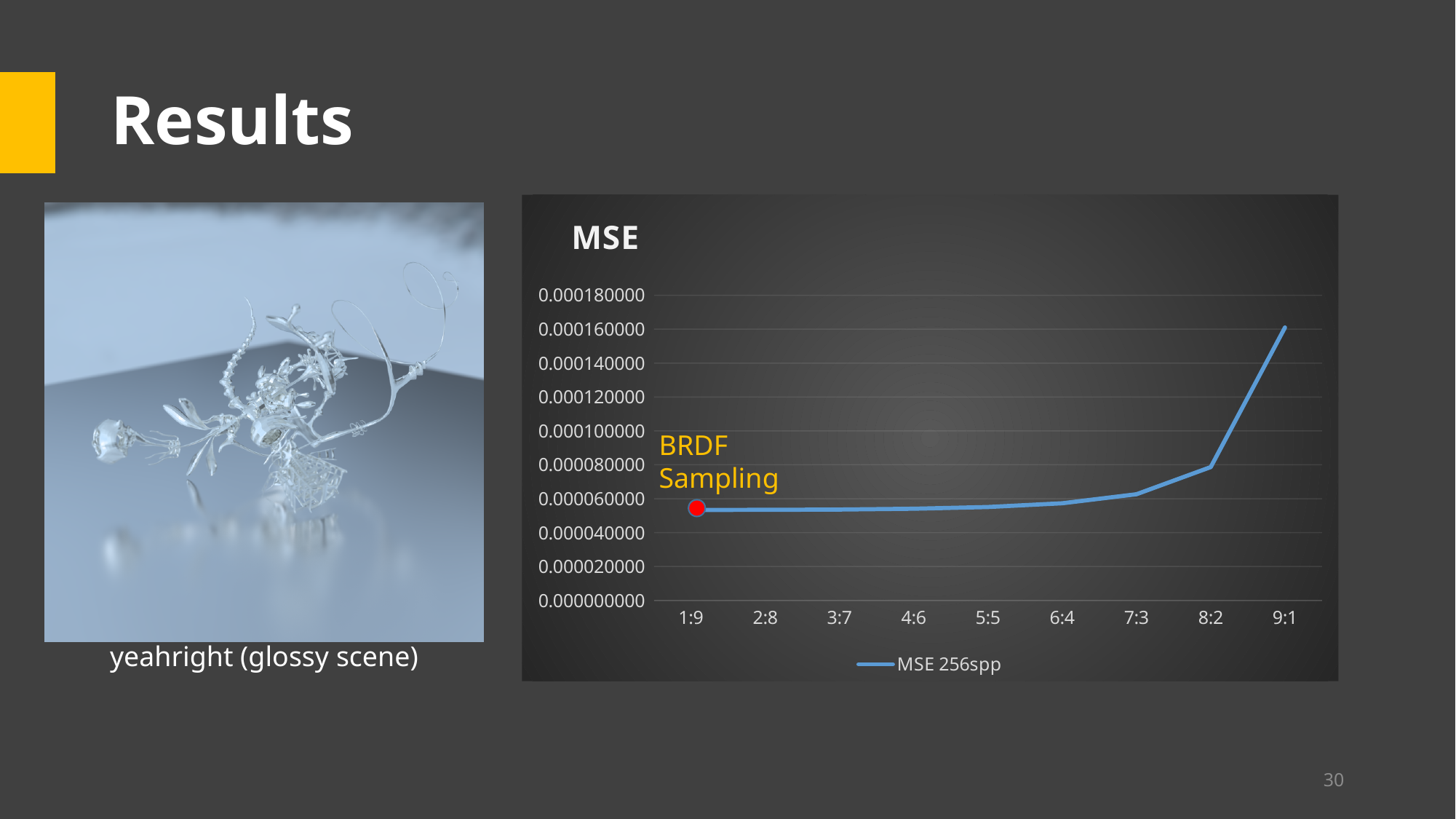
How many categories are shown on the x axis of the chart? 9 Is the MSE value for 8:2 greater or less than 0.000100000? less What is the title of the chart? MSE Do the MSE values generally rise or fall moving from 1:9 to 9:1 along the x axis? rise How many series does the chart legend list? 1 Is the MSE value for 1:9 greater or less than 0.000080000? less What kind of chart is shown on the slide? line chart Which has the larger MSE value, 8:2 or 9:1? 9:1 Is the MSE value for 8:2 greater or less than 0.000060000? greater What is the name of the series in the chart legend? MSE 256spp Which category has the highest MSE value? 9:1